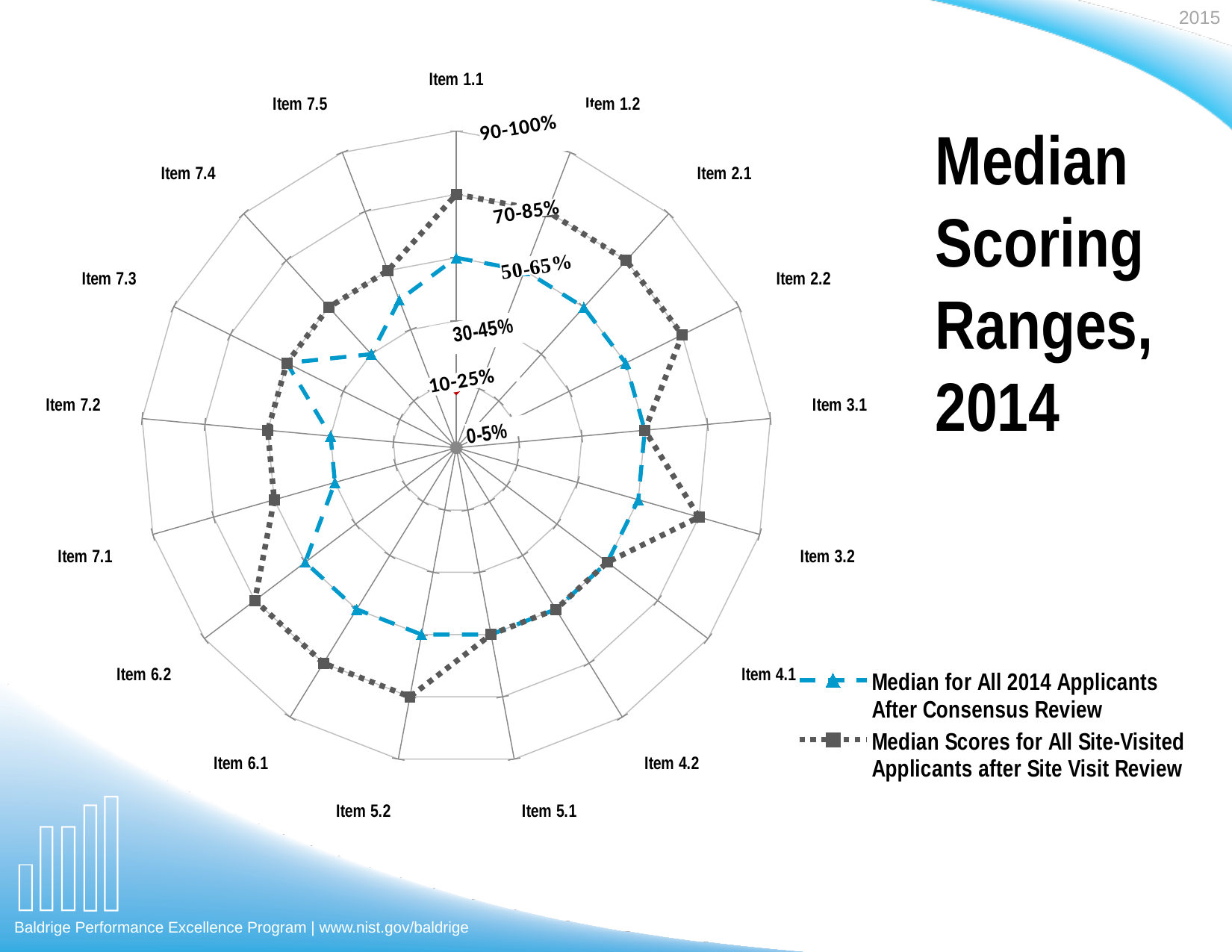
What is the title of the chart on the slide? Median Scoring Ranges, 2014 How many items (categories) are plotted around the radar chart? 17 What kind of chart is shown on the slide? Radar chart What is the label of the outermost ring of the radar chart? 90-100% How many labeled scoring-range rings does the radar chart have? 6 Which series is drawn with a blue dashed line and triangle markers? Median for All 2014 Applicants After Consensus Review What is the label of the innermost ring of the radar chart? 0-5% For Item 1.1, is the consensus review median or the site-visited median further from the center of the chart? Median Scores for All Site-Visited Applicants after Site Visit Review For Item 7.2, which series has the higher median scoring range: the consensus review series or the site-visited series? Median Scores for All Site-Visited Applicants after Site Visit Review For Item 3.2, which series has the higher median scoring range? Median Scores for All Site-Visited Applicants after Site Visit Review How many series does the legend list? 2